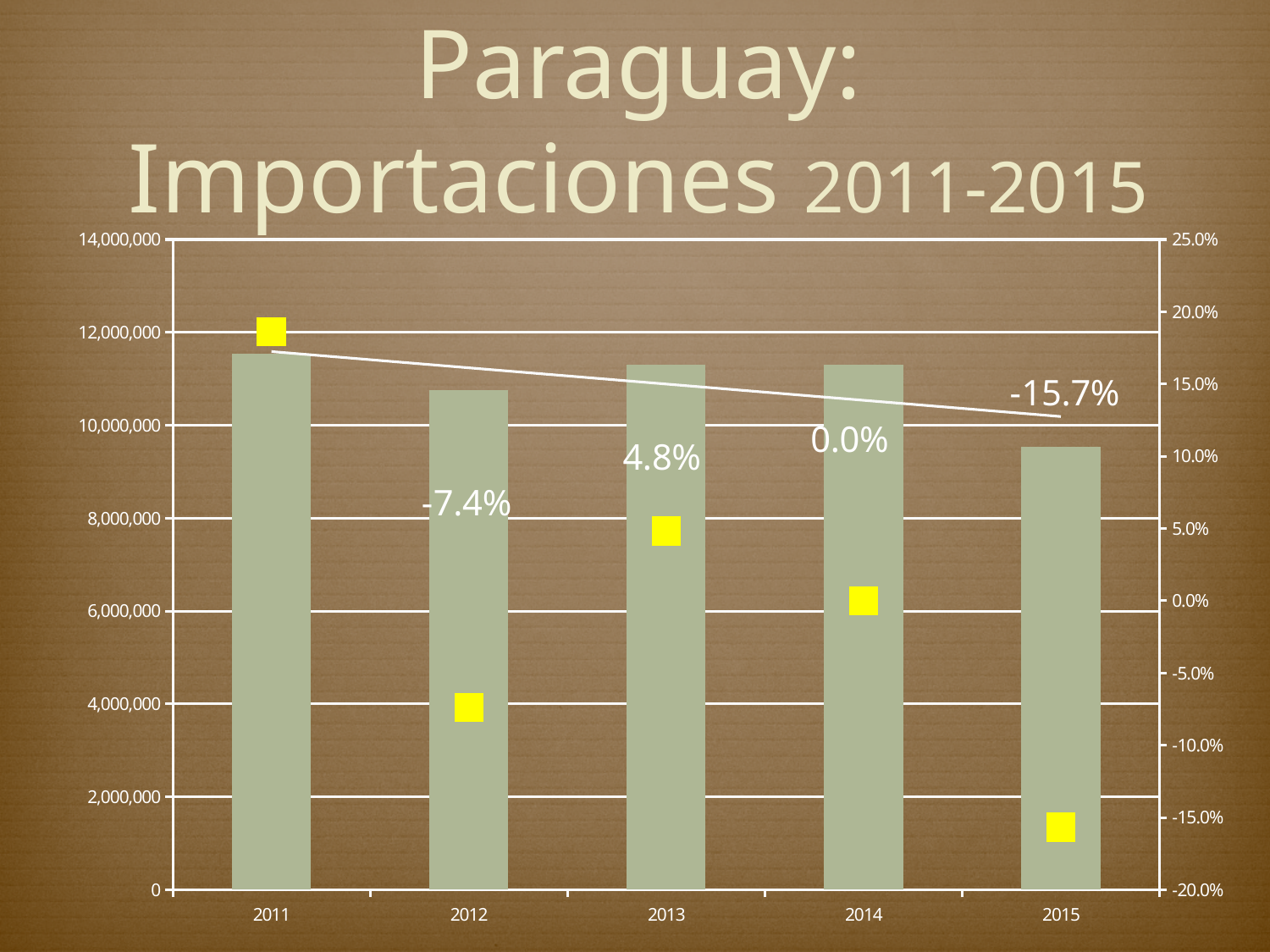
What is the percentage change shown for 2014? 0.0% What is the title of the chart? Paraguay: Importaciones 2011-2015 Which year has the shortest bar? 2015 Which year has the lowest percentage change marker? 2015 Is the bar value for 2015 greater or less than 10,000,000? less Which year has the highest percentage change marker? 2011 How many years are shown on the x axis? 5 What is the percentage change shown for 2012? -7.4% What is the percentage change shown for 2013? 4.8% Is the bar value for 2011 greater or less than 10,000,000? greater Which is larger, the percentage change for 2012 or for 2015? 2012 What is the percentage change shown for 2015? -15.7%